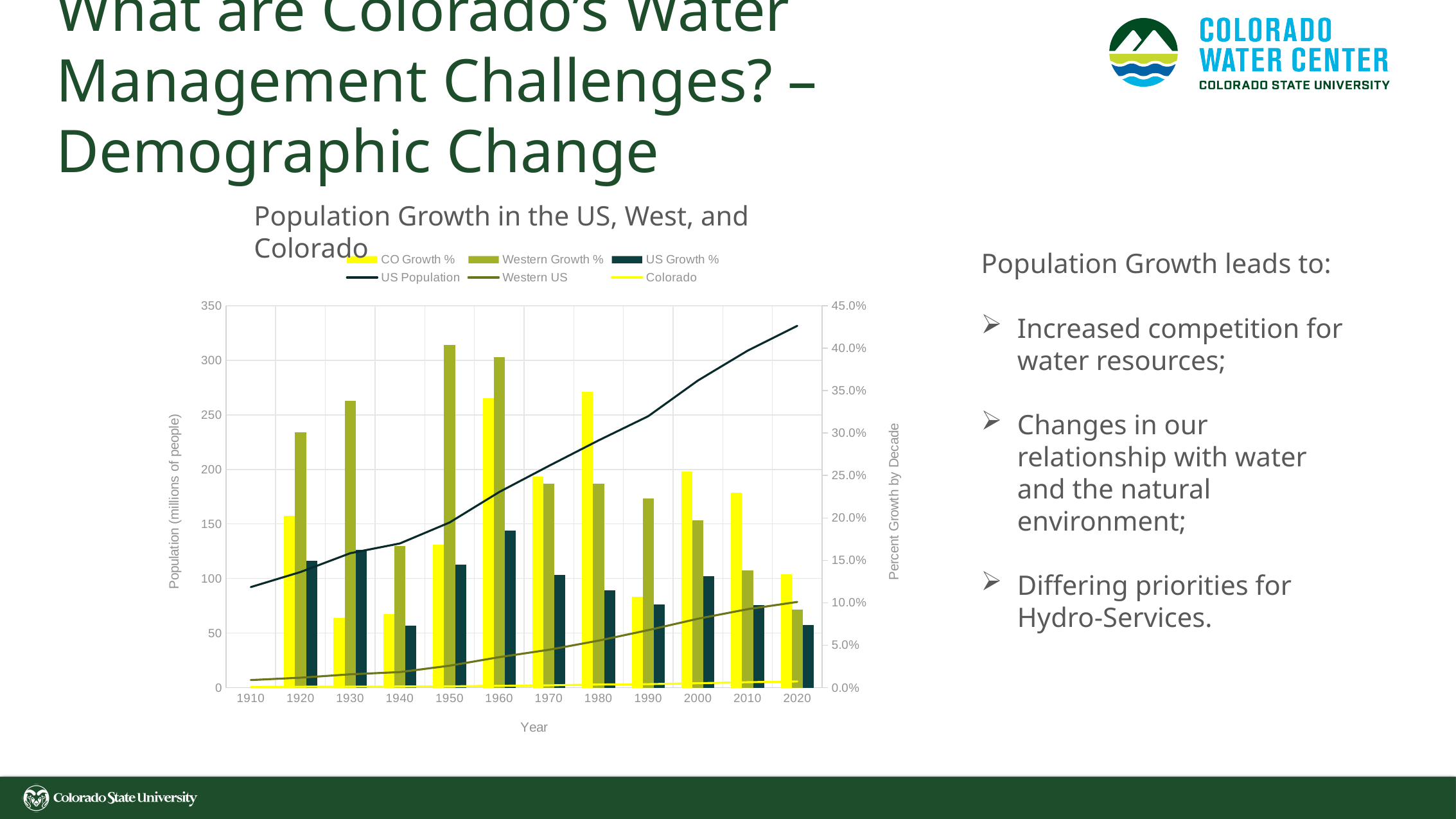
In 1950, which is larger: the CO Growth % bar or the Western Growth % bar? Western Growth % In which year is the CO Growth % bar highest? 1980 How many years are shown along the x axis of the chart? 12 What is the title of the chart on the slide? Population Growth in the US, West, and Colorado Is the US Population value for 2020 greater or less than 300 million people? greater In which year is the Western Growth % bar highest? 1950 Is the US Growth % value for 2020 greater or less than 10.0%? less How many series does the chart's legend list? 6 Does the US Population line rise or fall from 1910 to 2020? rise Is the Western Growth % value for 1950 greater or less than 35.0%? greater What kind of chart is shown on the slide? Combined bar and line chart